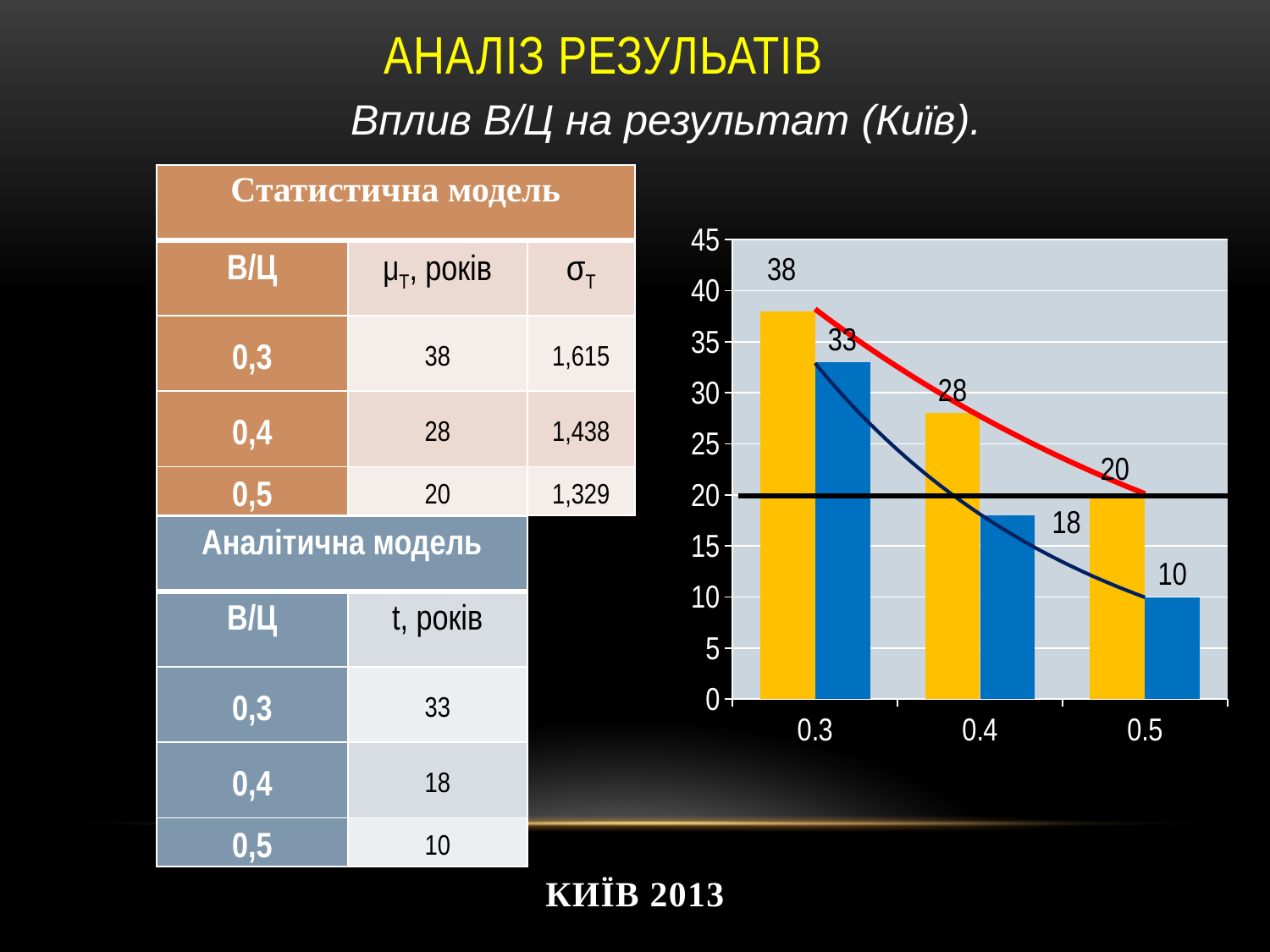
What is the value of the blue bar at 0.5? 10 What is the value of the yellow bar at 0.3? 38 By how much does the yellow bar at 0.3 exceed the yellow bar at 0.5? 18 How many categories are shown on the x axis of the chart? 3 What is the value of the yellow bar at 0.4? 28 What is the difference between the yellow bar and the blue bar at 0.3? 5 What is the value of the blue bar at 0.4? 18 What kind of chart is shown on the slide? bar chart Do the yellow bars rise or fall as the x-axis value increases from 0.3 to 0.5? fall At which x-axis category is the blue bar lowest? 0.5 At which x-axis category is the yellow bar highest? 0.3 At 0.4, which bar is larger, the yellow one or the blue one? yellow